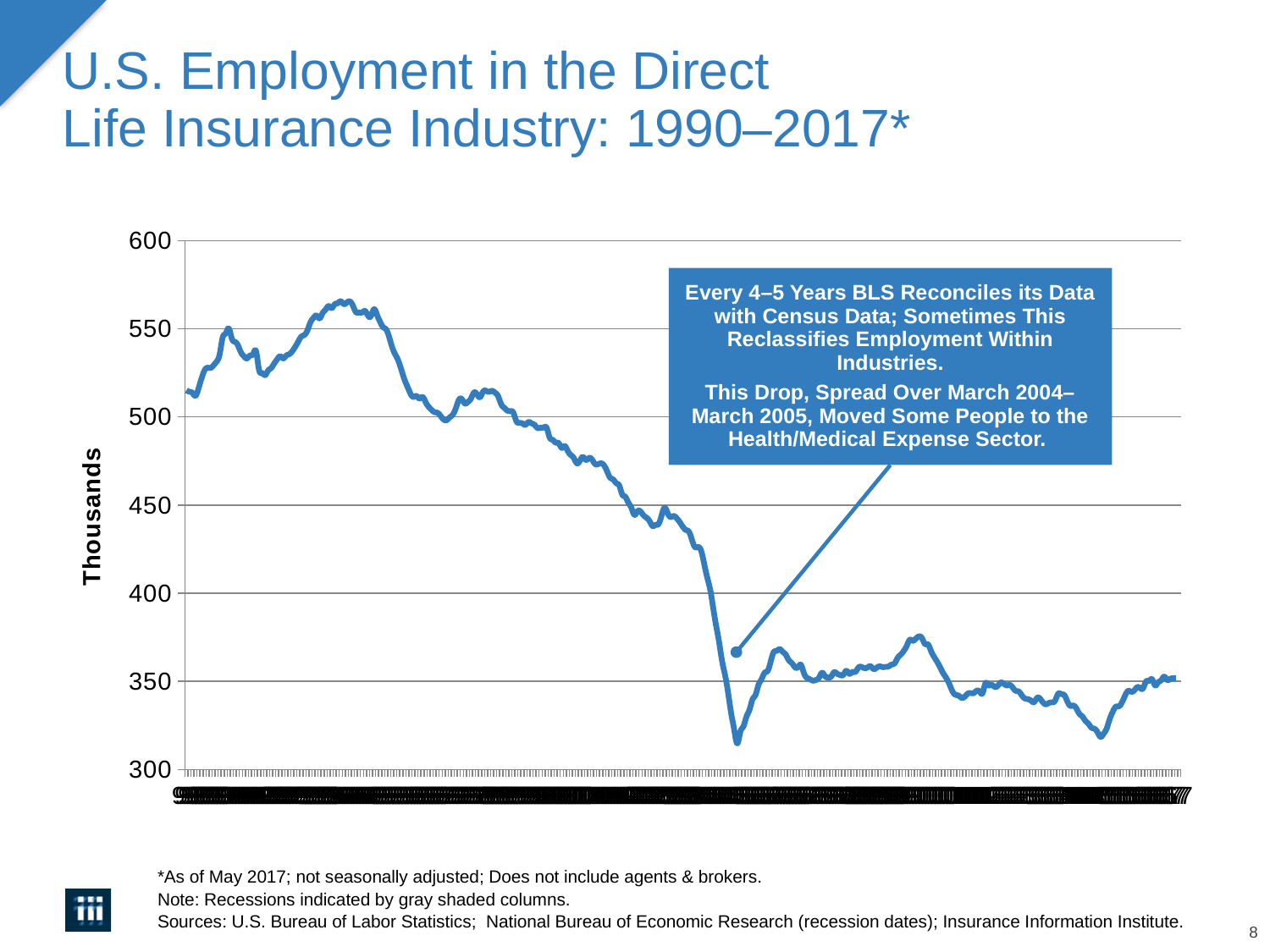
Is the value at the end of the series (2017) greater or less than 400? less What is the label on the vertical axis of the chart? Thousands What is the lowest value shown on the vertical axis? 300 Is the highest point of the line greater or less than 550? greater Overall, does employment rise or fall from the start of the series to the end? Fall Is the value at the end of the series (2017) greater or less than 300? greater What kind of chart is shown on the slide? Line chart What is the title of the chart on the slide? U.S. Employment in the Direct Life Insurance Industry: 1990–2017* Is the value at the start of the series (1990) larger or smaller than the value at the end of the series (2017)? larger